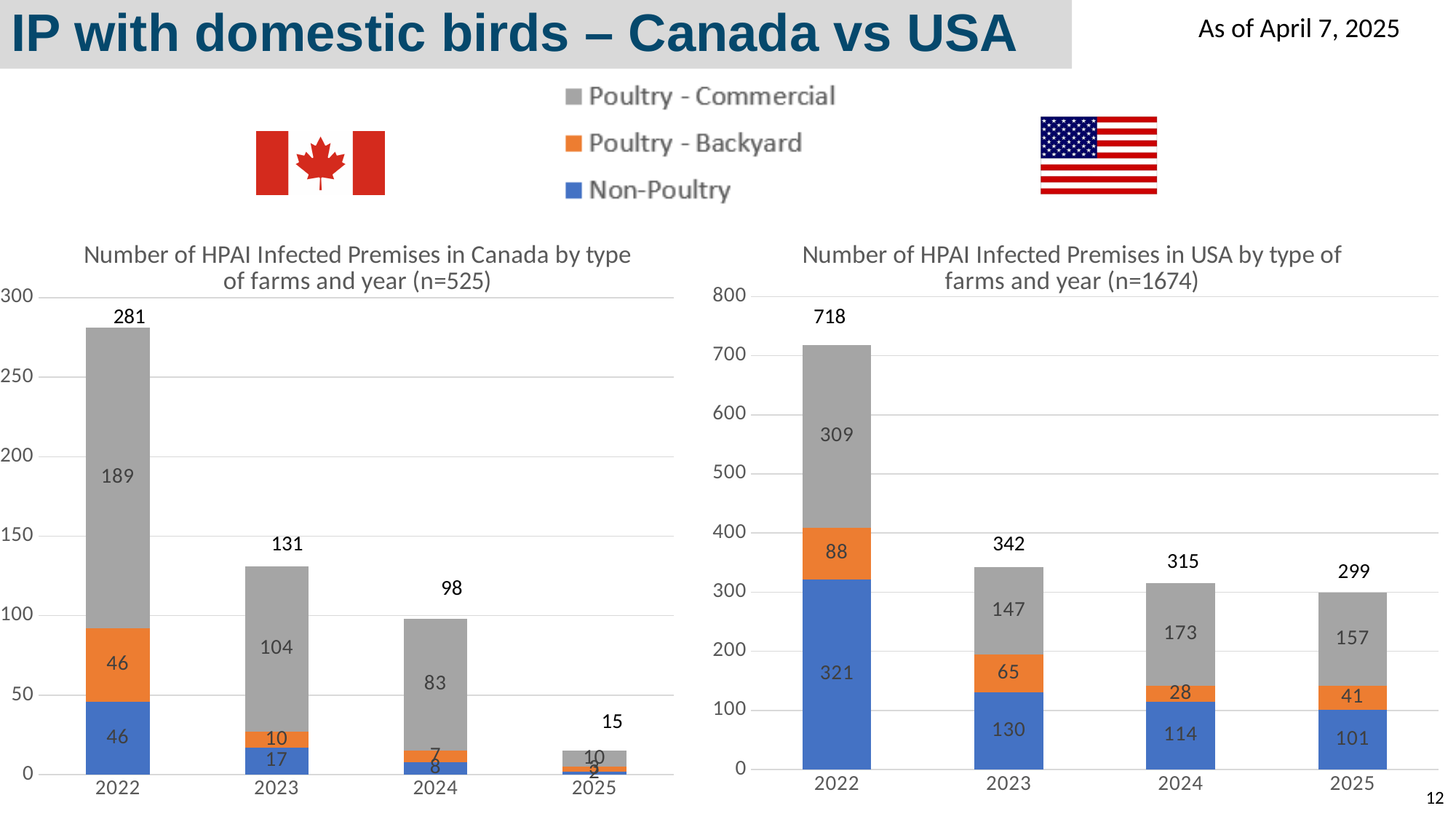
In the Canada chart, which year has the lowest total number of infected premises? 2025 In the USA chart, what is the difference between the total for 2023 and the total for 2024? 27 How many years are shown on the x axis of the USA chart? 4 In the Canada chart, what is the Poultry - Backyard value for 2023? 10 In the Canada chart, which is larger in 2024: the Poultry - Commercial value or the Non-Poultry value? Poultry - Commercial In the USA chart, what is the Non-Poultry value for 2022? 321 In the Canada chart, what is the total number of HPAI infected premises in 2022? 281 In the USA chart, what is the Poultry - Commercial value for 2024? 173 How many series does the legend list? 3 What kind of chart is the Canada chart? Stacked bar chart In the Canada chart, do the total values rise or fall from 2022 to 2025? Fall In the USA chart, which year has the highest total number of infected premises? 2022